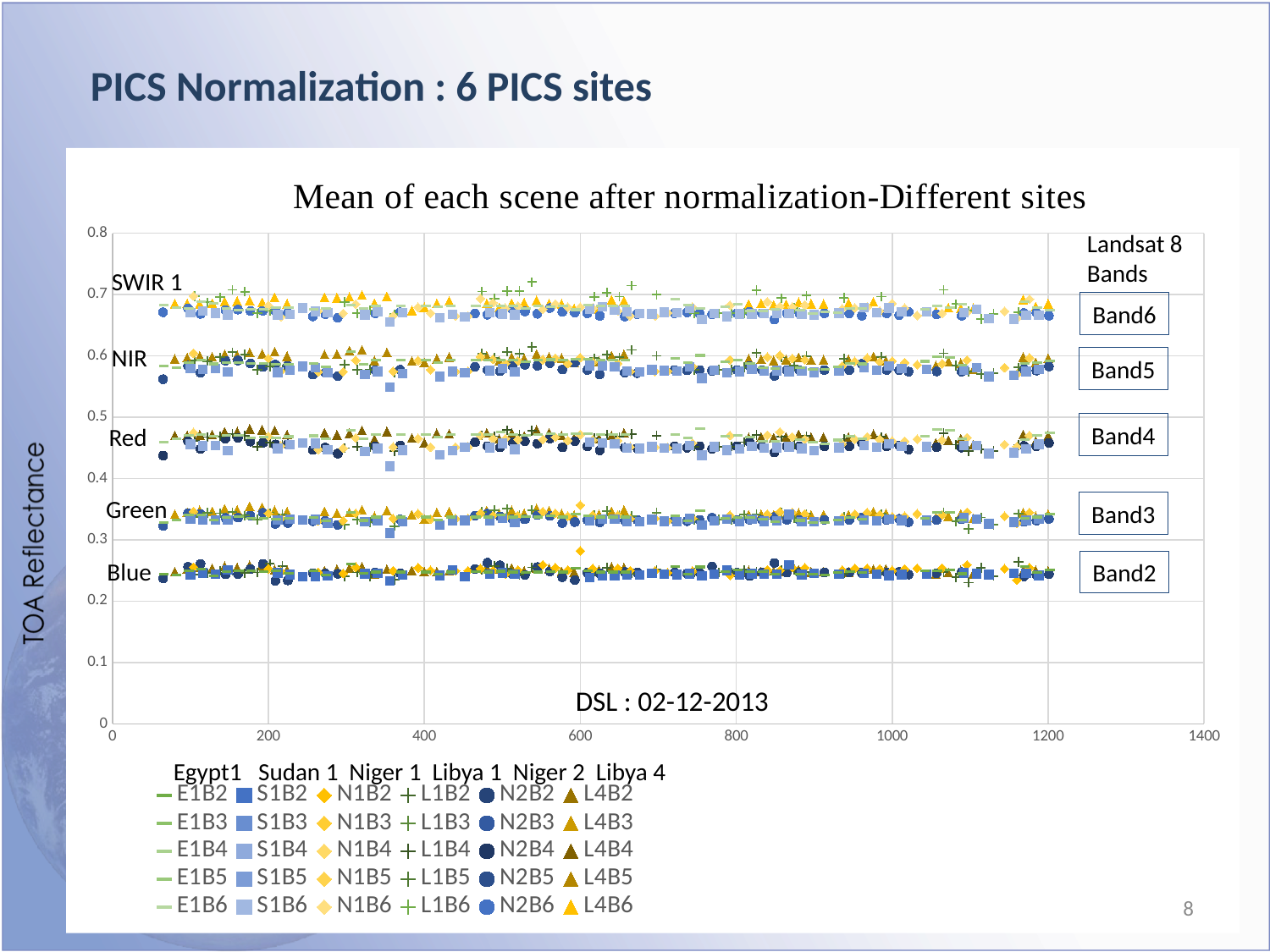
What is the title of the chart? Mean of each scene after normalization-Different sites Do the values for each band rise, fall, or stay roughly flat along the x axis? stay roughly flat Are the Red band values greater or less than 0.5? less What kind of chart is shown on the slide? scatter chart Which band has the lowest TOA reflectance values in the chart? Blue Are the SWIR 1 values greater or less than 0.6? greater What is the label of the y axis? TOA Reflectance How many PICS sites are plotted in the chart? 6 Which band has the highest TOA reflectance values in the chart? SWIR 1 Which has higher TOA reflectance values, the NIR band or the Red band? NIR Are the Blue band values greater or less than 0.3? less How many series does the legend list? 30